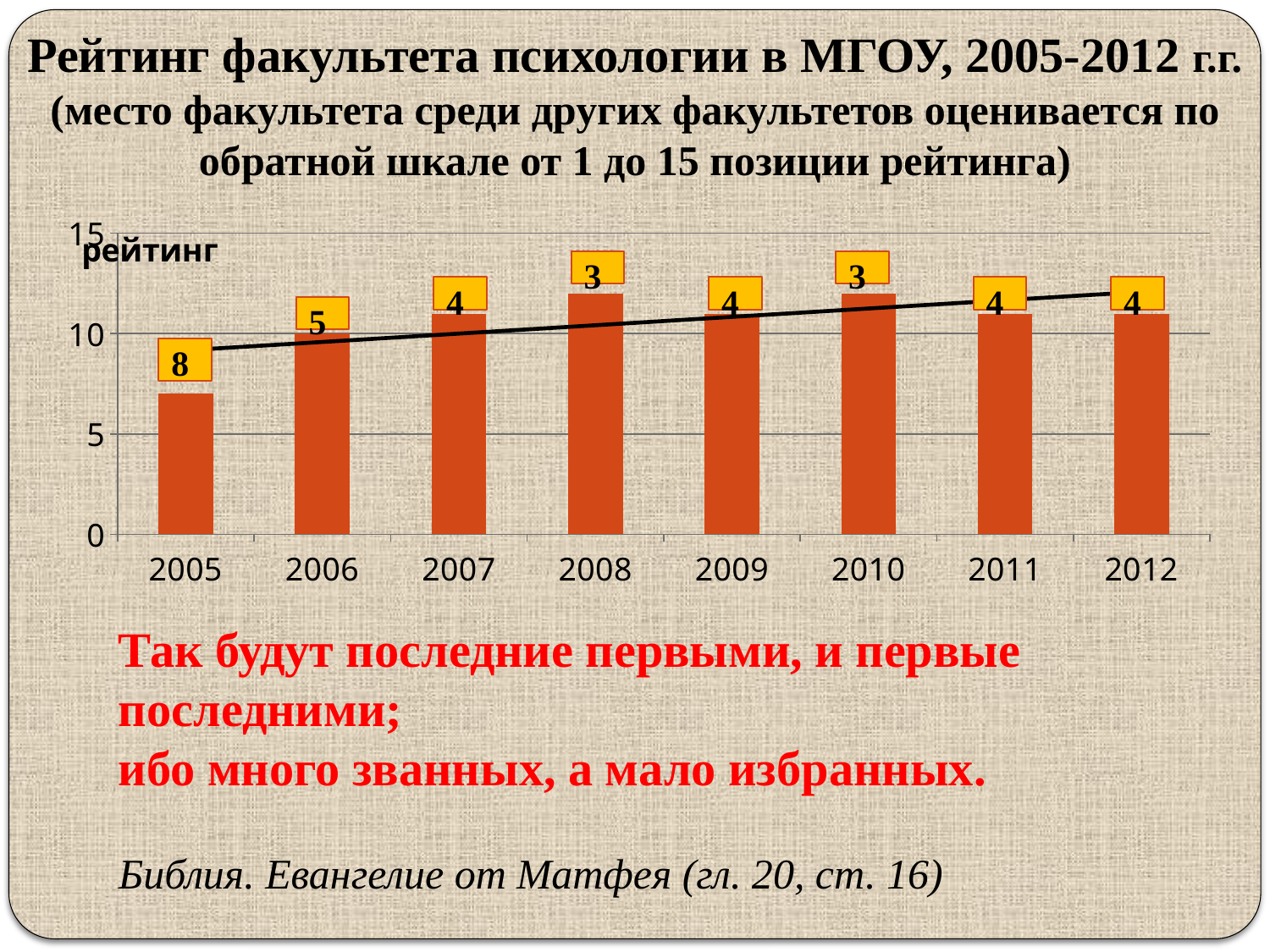
Which year has the largest data label printed on its bar? 2005 What is the data label shown on the bar for 2008? 3 What is the difference between the data labels for 2005 and 2006? 3 What is the data label shown on the bar for 2006? 5 What kind of chart is shown on the slide? bar chart What is the data label shown on the bar for 2012? 4 Does the trend line drawn across the bars rise or fall from 2005 to 2012? rise Which bar is taller, the one for 2005 or the one for 2008? 2008 What is the data label shown on the bar for 2005? 8 Is the height of the bar for 2005 greater or less than 10 on the axis? less How many years are shown on the x axis of the chart? 8 Which year has the shortest bar in the chart? 2005